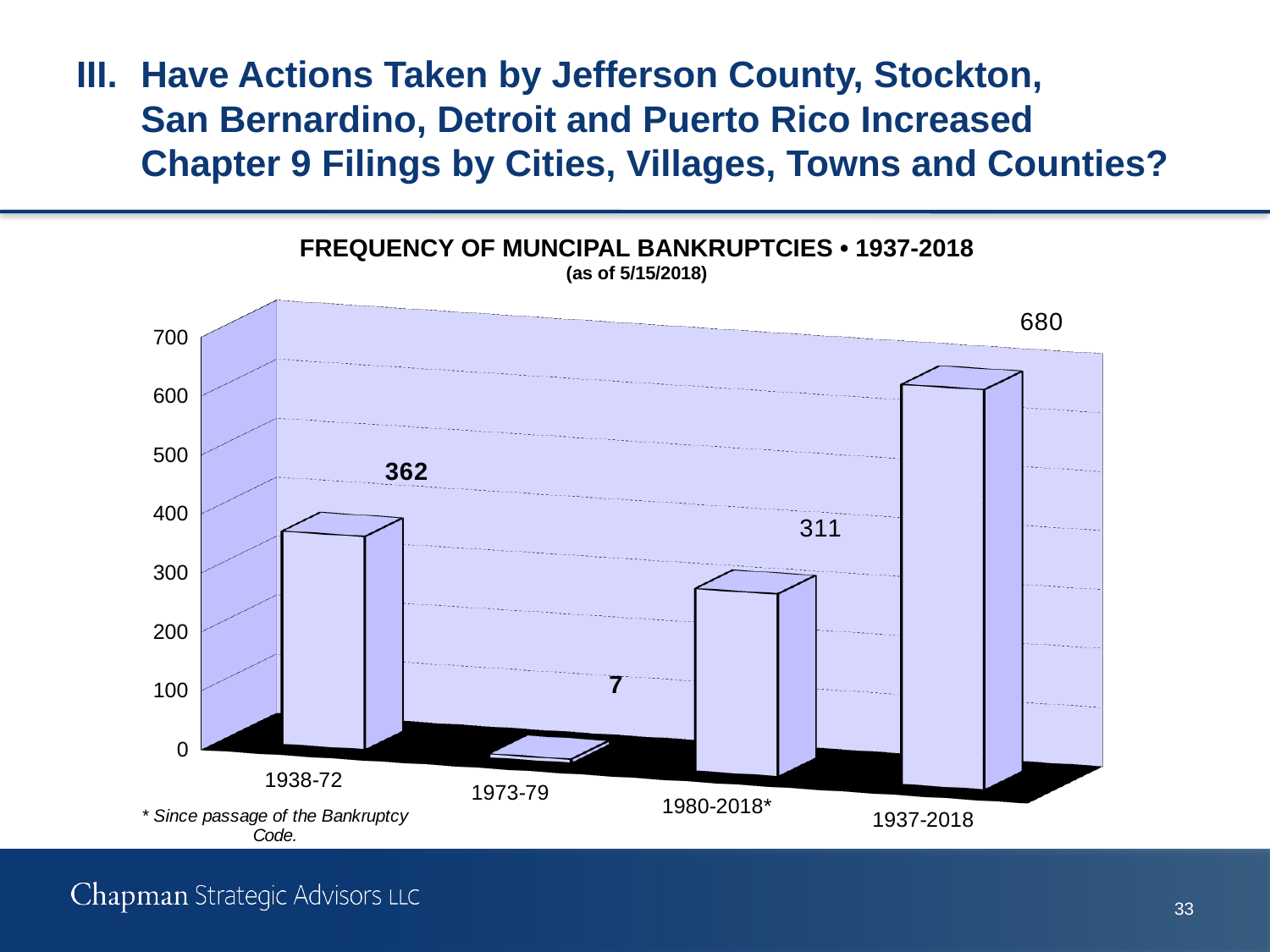
How many categories are shown on the x axis? 4 Which category has the lowest value? 1973-79 What is the value for 1980-2018*? 311 What is the value for 1938-72? 362 What is the value for 1973-79? 7 What kind of chart is shown on the slide? bar chart What is the title of the chart? FREQUENCY OF MUNCIPAL BANKRUPTCIES • 1937-2018 Which is larger, the value for 1938-72 or the value for 1980-2018*? 1938-72 What is the value for 1937-2018? 680 What is the difference between the values for 1938-72 and 1980-2018*? 51 Is the value for 1937-2018 greater or less than 600? greater Which category has the highest value? 1937-2018